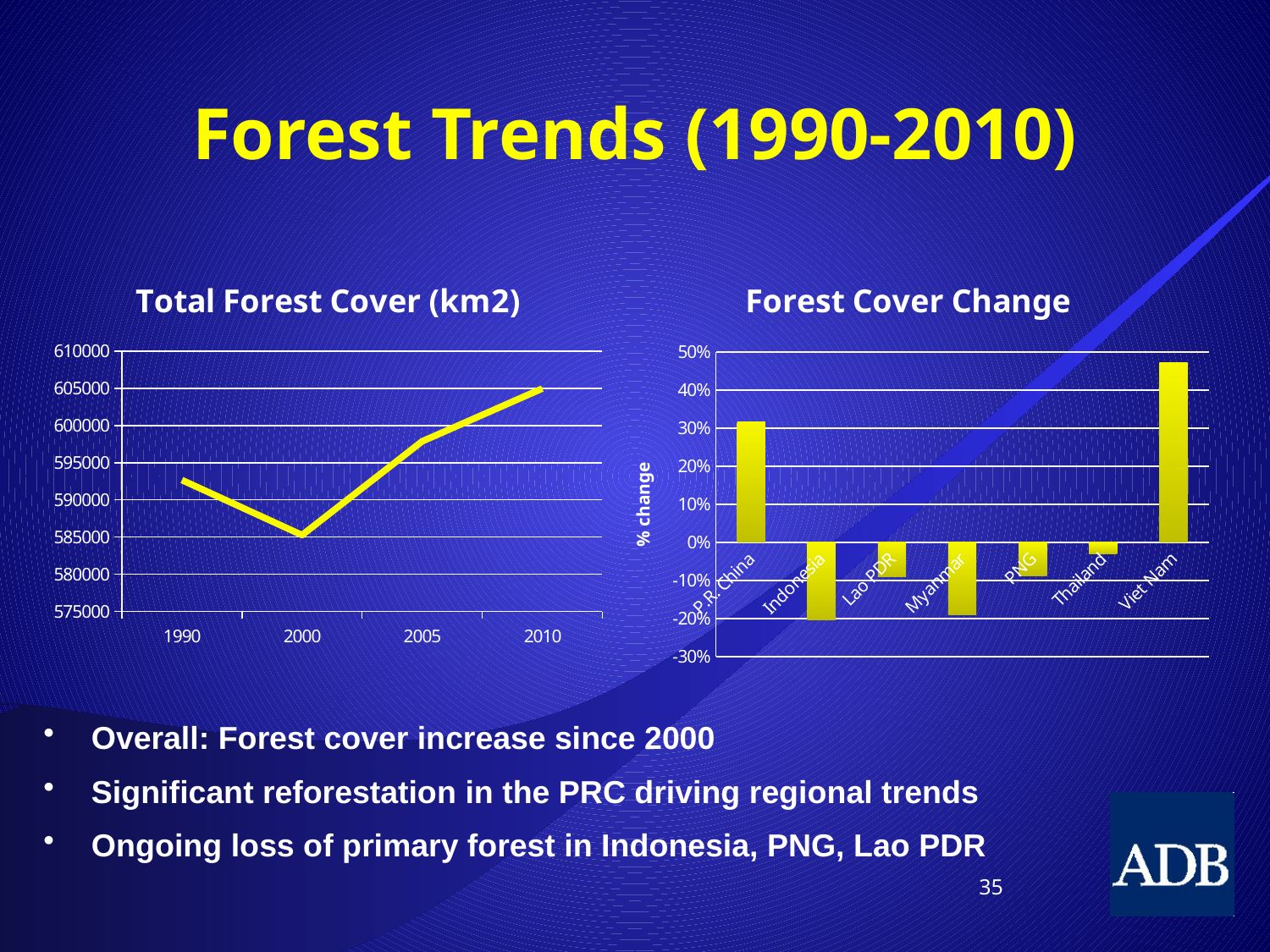
In the 'Forest Cover Change' chart, how many countries are shown? 7 What type of chart is the 'Forest Cover Change' chart? bar chart What type of chart is the 'Total Forest Cover (km2)' chart? line chart In the 'Forest Cover Change' chart, which is larger, the value for Thailand or the value for Indonesia? Thailand In the 'Total Forest Cover (km2)' chart, does forest cover rise or fall between 2000 and 2010? rise In the 'Total Forest Cover (km2)' chart, how many years are shown on the x axis? 4 In the 'Total Forest Cover (km2)' chart, which year has the highest forest cover? 2010 In the 'Total Forest Cover (km2)' chart, which year has the lowest forest cover? 2000 In the 'Forest Cover Change' chart, is the value for P.R. China greater or less than 20%? greater In the 'Total Forest Cover (km2)' chart, is the value for 2010 greater or less than 600000? greater In the 'Total Forest Cover (km2)' chart, is the value for 2000 greater or less than 590000? less In the 'Forest Cover Change' chart, which country has the highest percentage change? Viet Nam